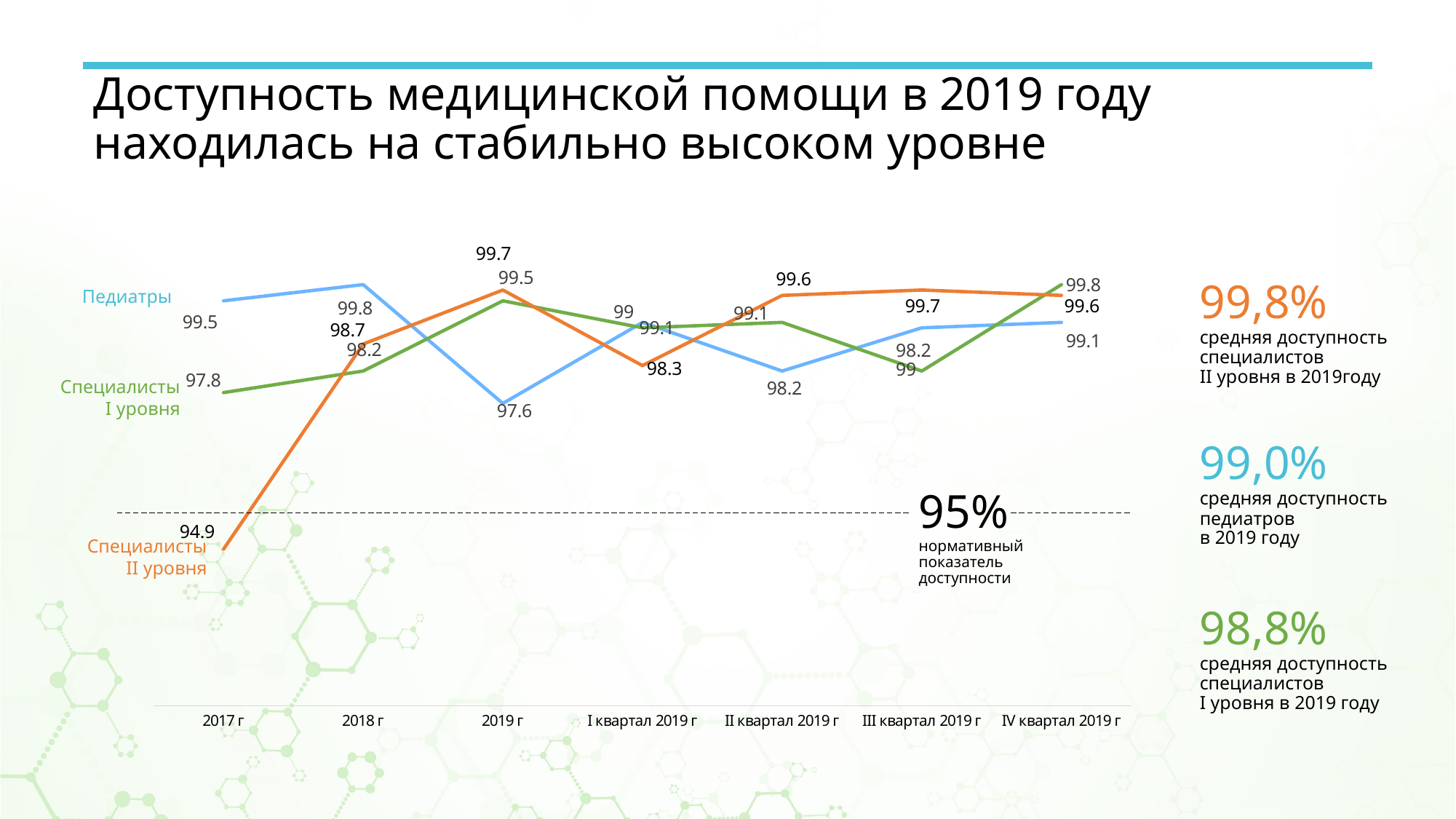
What value does the dashed horizontal line (нормативный показатель доступности) mark? 95% How many series are plotted on the chart? 3 In which period does the Специалисты II уровня line reach its lowest value? 2017 г What is the value for Специалисты I уровня in IV квартал 2019 г? 99.8 What is the value for Специалисты II уровня in 2017 г? 94.9 What is the value for Педиатры in 2017 г? 99.5 What is the value for Специалисты II уровня in III квартал 2019 г? 99.7 In which period does the Педиатры line reach its lowest value? 2019 г What kind of chart is shown on the slide? line chart How many periods are shown on the x axis? 7 By how much did the value for Специалисты II уровня increase from 2017 г to 2018 г? 3.8 In 2019 г, which is higher: Педиатры or Специалисты I уровня? Специалисты I уровня